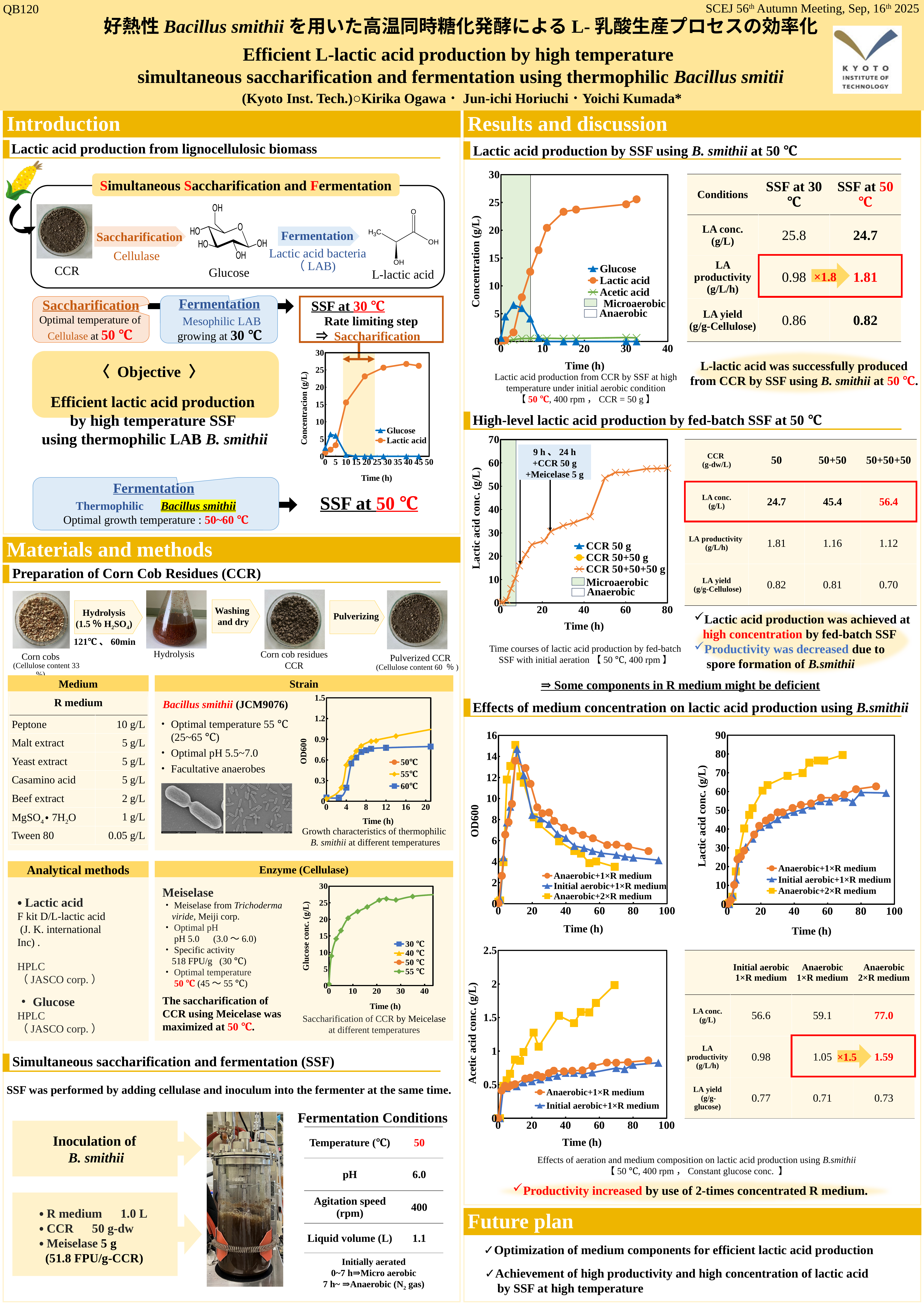
In the 'Saccharification of CCR by Meicelase at different temperatures' chart, how many temperature series does the legend list? 4 In the fed-batch SSF chart (Lactic acid conc. vs Time), does the lactic acid concentration for CCR 50+50+50 g rise or fall over time? Rise In the 'Saccharification of CCR by Meicelase' chart, is the glucose concentration at 40 h for 55 °C greater or less than 20 g/L? greater In the lactic acid concentration chart under 'Effects of medium concentration', which series is higher at 60 h: Anaerobic+2×R medium or Anaerobic+1×R medium? Anaerobic+2×R medium In the OD600 chart under 'Effects of medium concentration', is the peak OD600 value greater or less than 12? greater In the fed-batch SSF chart, is the final lactic acid concentration for CCR 50+50+50 g at 80 h greater or less than 50 g/L? greater In the 'Growth characteristics of thermophilic B. smithii' chart, how many temperature series does the legend list? 3 What is the x-axis label of the fed-batch SSF chart? Time (h) In the OD600 chart under 'Effects of medium concentration', after the peak near 10 h, do the OD600 values rise or fall with time? Fall In the acetic acid concentration chart, how many series does the legend list? 2 What kind of chart is the 'Lactic acid production by SSF using B. smithii at 50 °C' chart? Line chart